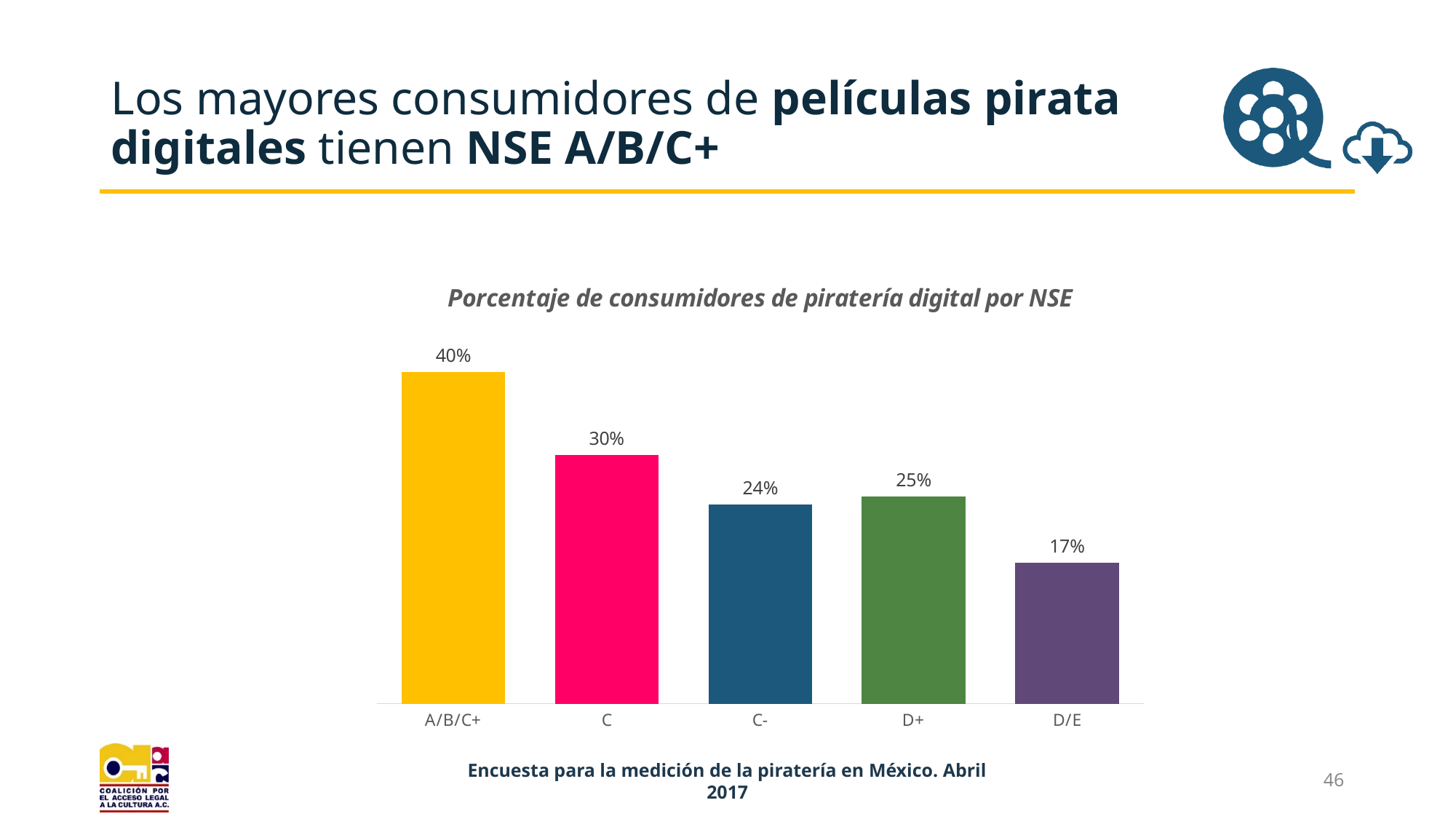
What is the value for D/E? 17% How many NSE categories are shown in the chart? 5 What is the difference between the values for A/B/C+ and C? 10% What is the value for A/B/C+? 40% What is the value for C-? 24% What is the difference between the values for D+ and D/E? 8% What is the title of the chart? Porcentaje de consumidores de piratería digital por NSE Which is larger, the value for C or the value for D+? C Which NSE category has the highest percentage? A/B/C+ Which NSE category has the lowest percentage? D/E What colour is the bar for A/B/C+? Yellow What kind of chart is shown on the slide? Bar chart